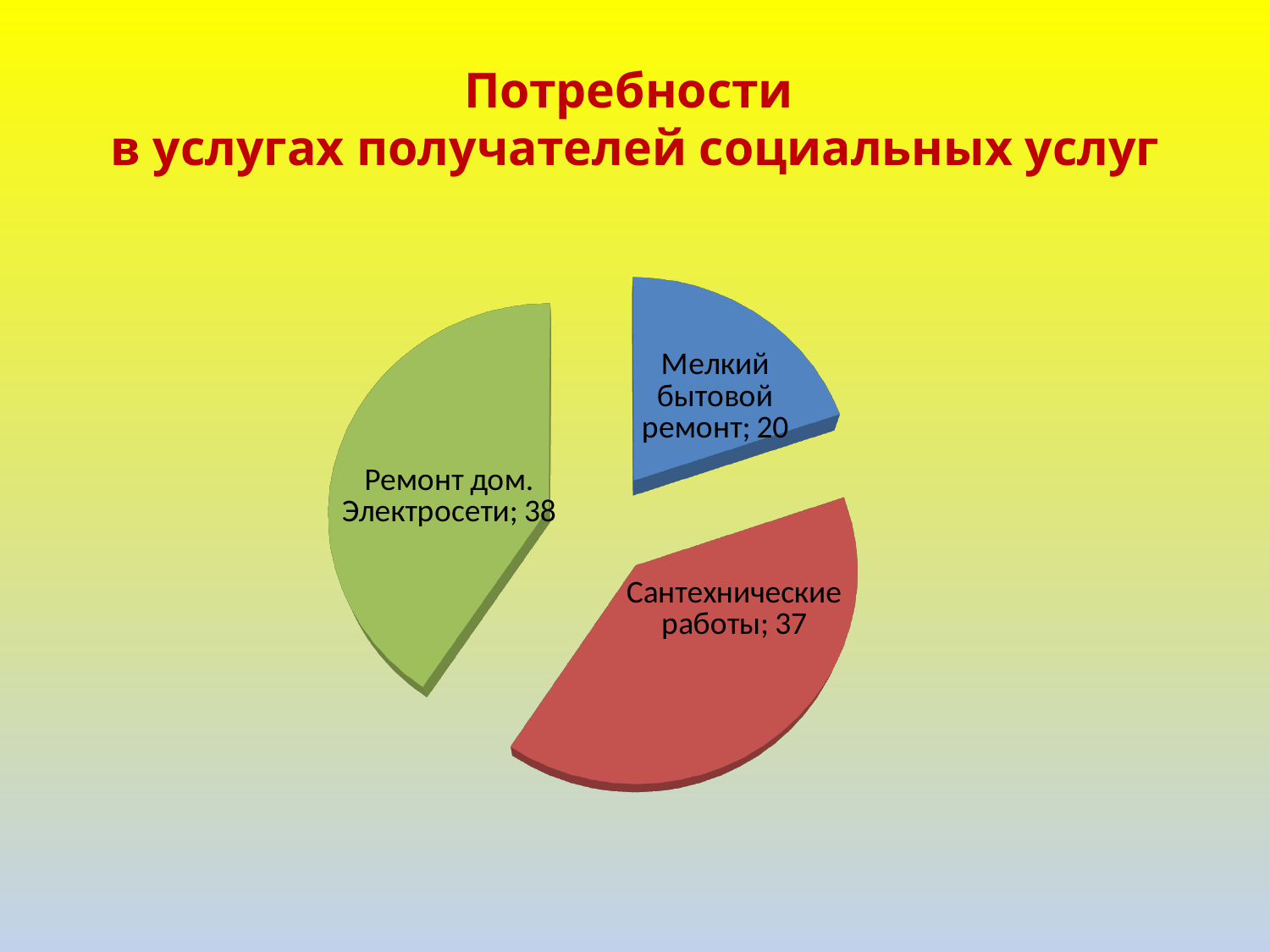
What kind of chart is shown on the slide? Pie chart What is the value for Ремонт дом. Электросети? 38 How many slices does the pie chart have? 3 What is the difference between the values for Ремонт дом. Электросети and Сантехнические работы? 1 What is the title of the slide? Потребности в услугах получателей социальных услуг What is the difference between the values for Сантехнические работы and Мелкий бытовой ремонт? 17 Which category has the largest value? Ремонт дом. Электросети Which category has the smallest value? Мелкий бытовой ремонт What is the value for Мелкий бытовой ремонт? 20 What is the value for Сантехнические работы? 37 Which is larger: the value for Сантехнические работы or the value for Мелкий бытовой ремонт? Сантехнические работы What share of the pie does Ремонт дом. Электросети represent? 40%